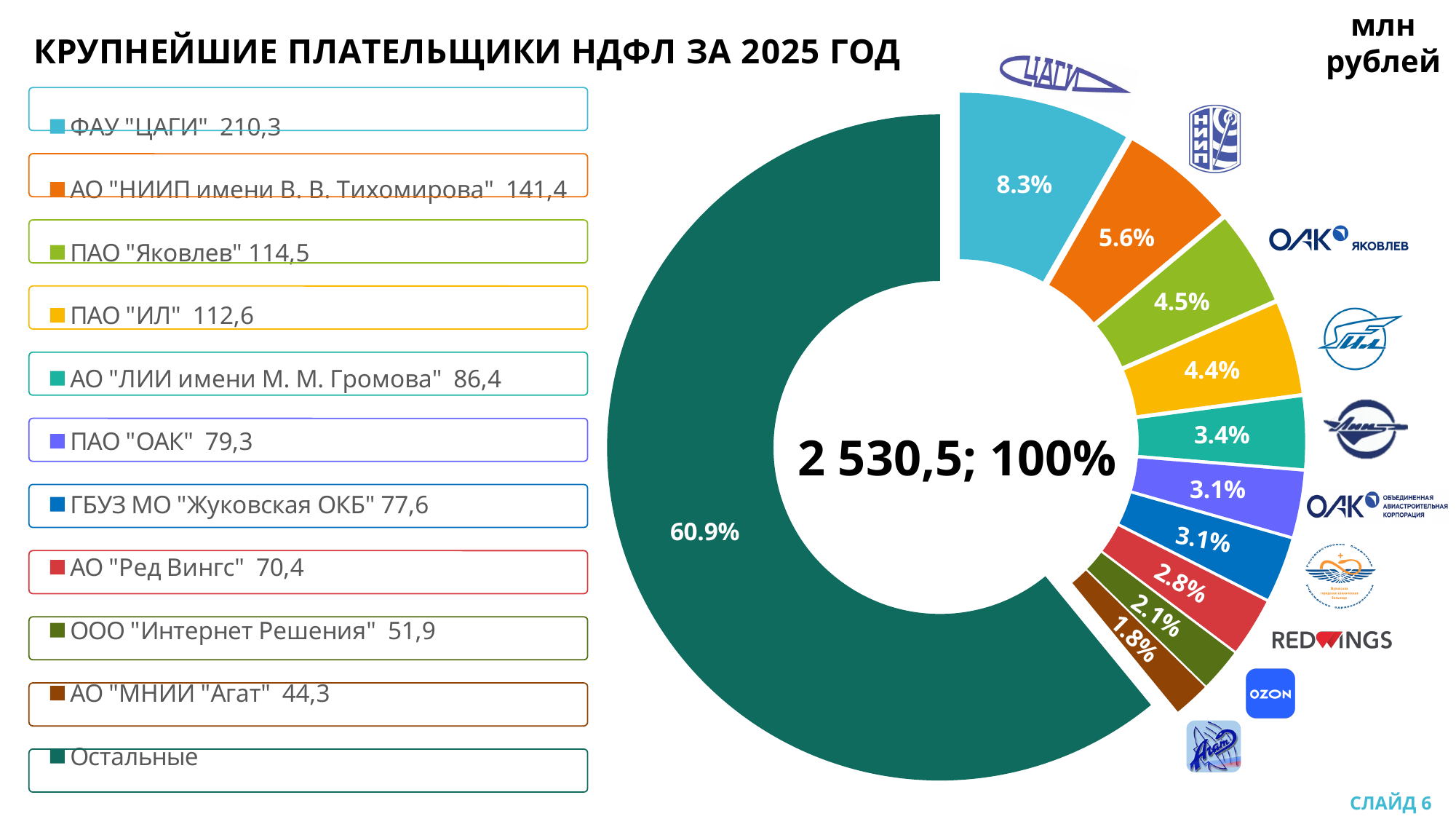
What is the value for ПАО "ИЛ"? 112,6 What share of the pie does ПАО "Яковлев" have? 4.5% What is the difference between the values for ФАУ "ЦАГИ" and АО "НИИП имени В. В. Тихомирова"? 68,9 Which of the named payers has the lowest value? АО "МНИИ "Агат" Which is larger, the value for ПАО "ОАК" or for ГБУЗ МО "Жуковская ОКБ"? ПАО "ОАК" Which slice is the largest in the chart? Остальные What kind of chart is shown on the slide? Donut (pie) chart What total is shown in the centre of the chart? 2 530,5; 100% What share of the pie does the Остальные slice have? 60.9% What is the value for ФАУ "ЦАГИ"? 210,3 How many categories (slices) does the chart have? 11 What is the value for АО "Ред Вингс"? 70,4